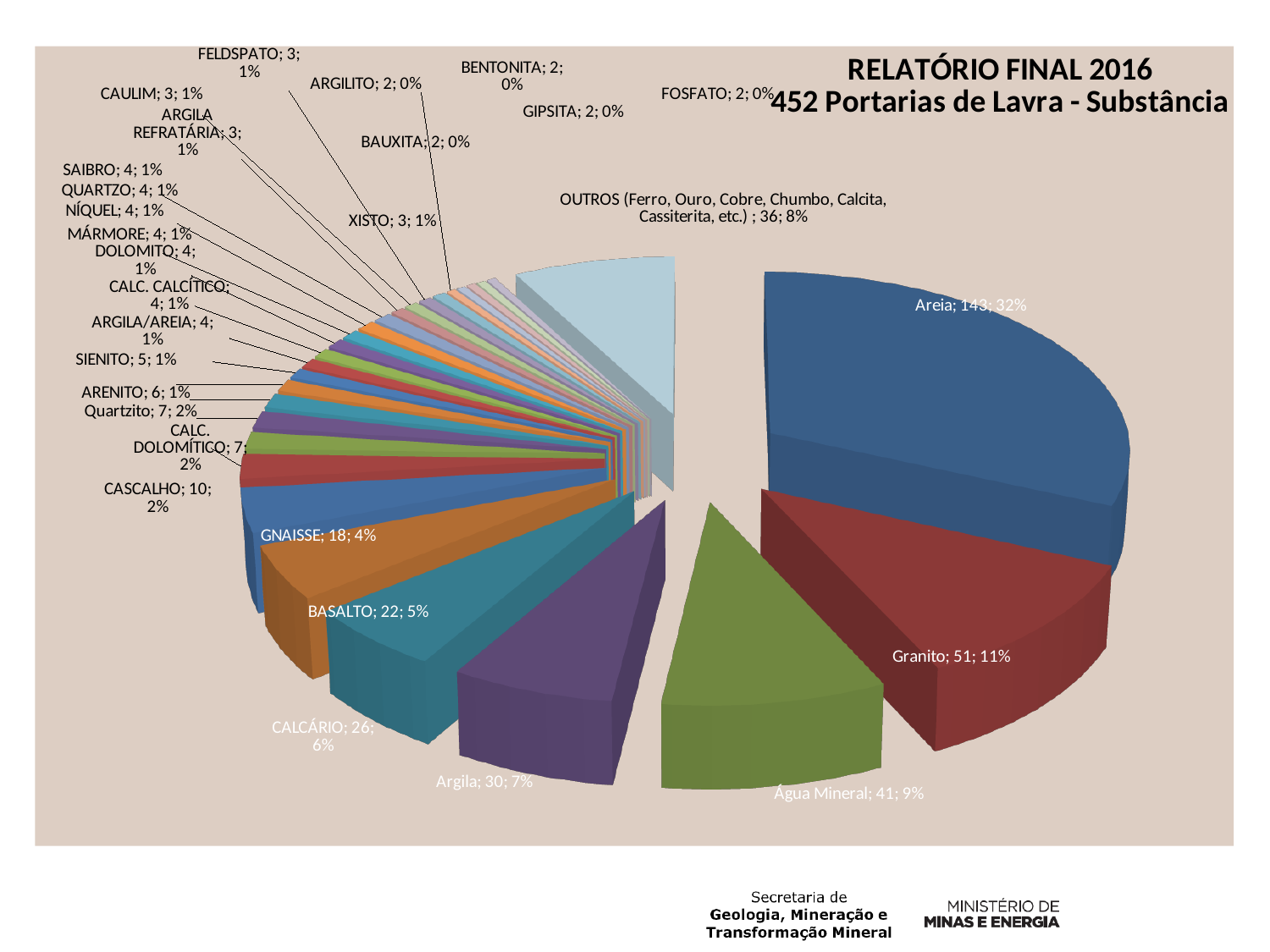
What is the value shown for Água Mineral? 41 Which substance has the largest slice of the pie? Areia Which has a larger value, Quartzito or ARENITO? Quartzito How many Portarias de Lavra are shown for Areia? 143 What percentage share does the OUTROS slice represent? 8% What is the difference between the values for Areia and Granito? 92 What is the difference between the values for GNAISSE and CASCALHO? 8 Which has a larger value, Argila or CALCÁRIO? Argila What is the title of the chart? RELATÓRIO FINAL 2016 452 Portarias de Lavra - Substância What is the value shown for BASALTO? 22 What percentage share of the pie does Granito have? 11% What kind of chart is shown on the slide? pie chart